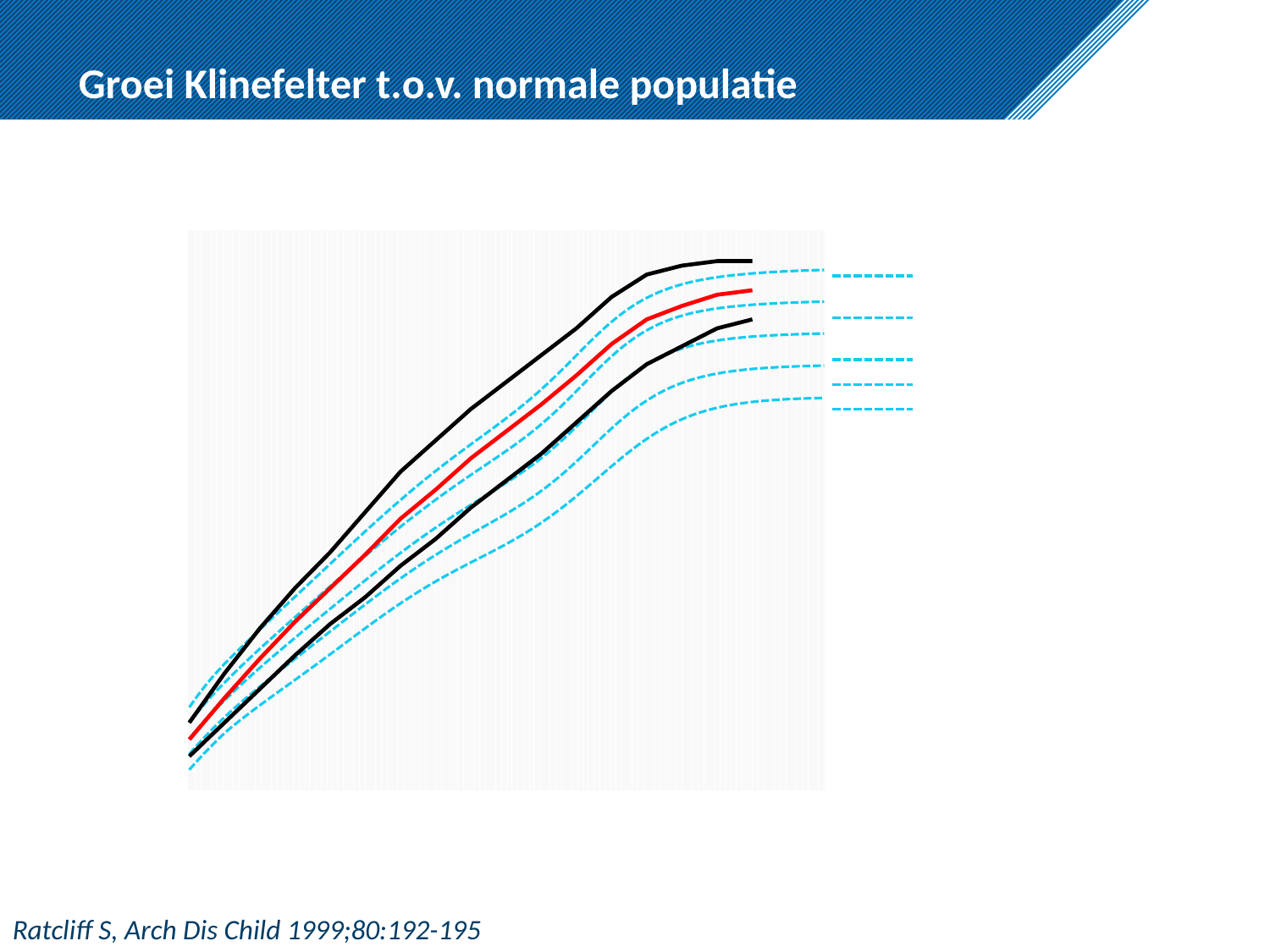
How many solid lines are plotted in the chart? 3 Do the plotted lines rise or fall from left to right? rise What is the title of the slide containing the chart? Groei Klinefelter t.o.v. normale populatie What colour is the middle solid line in the chart? red How many dashed lines are plotted in the chart? 5 What kind of chart is shown on the slide? line chart Do the lines flatten out or keep rising steeply at the right end of the chart? flatten out